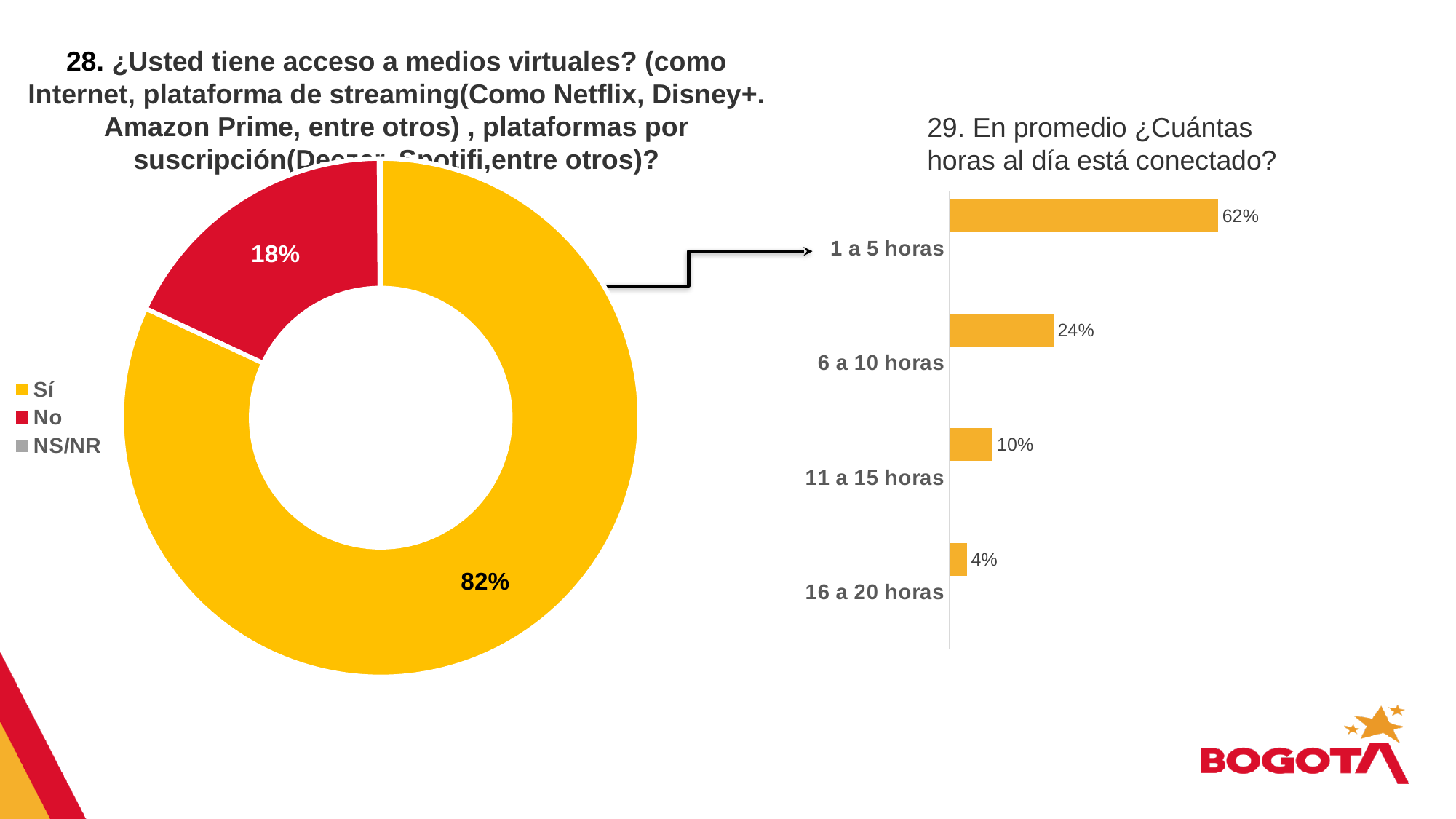
In the right chart (question 29), what is the value for '16 a 20 horas'? 4% In the right chart (question 29), what is the value for '1 a 5 horas'? 62% In the right chart (question 29), what is the value for '6 a 10 horas'? 24% In the right chart (question 29), how many categories are shown? 4 In the right chart (question 29), which category has the lowest value? 16 a 20 horas What kind of chart is the left chart (question 28)? Pie chart (doughnut) In the right chart (question 29), what is the difference between '1 a 5 horas' and '6 a 10 horas'? 38% In the left chart (question 28), what percentage answered 'No'? 18% In the left chart (question 28), what percentage answered 'Sí'? 82% In the left chart (question 28), how many entries does the legend list? 3 In the left chart (question 28), which response has the largest share? Sí What kind of chart is the right chart (question 29)? Bar chart